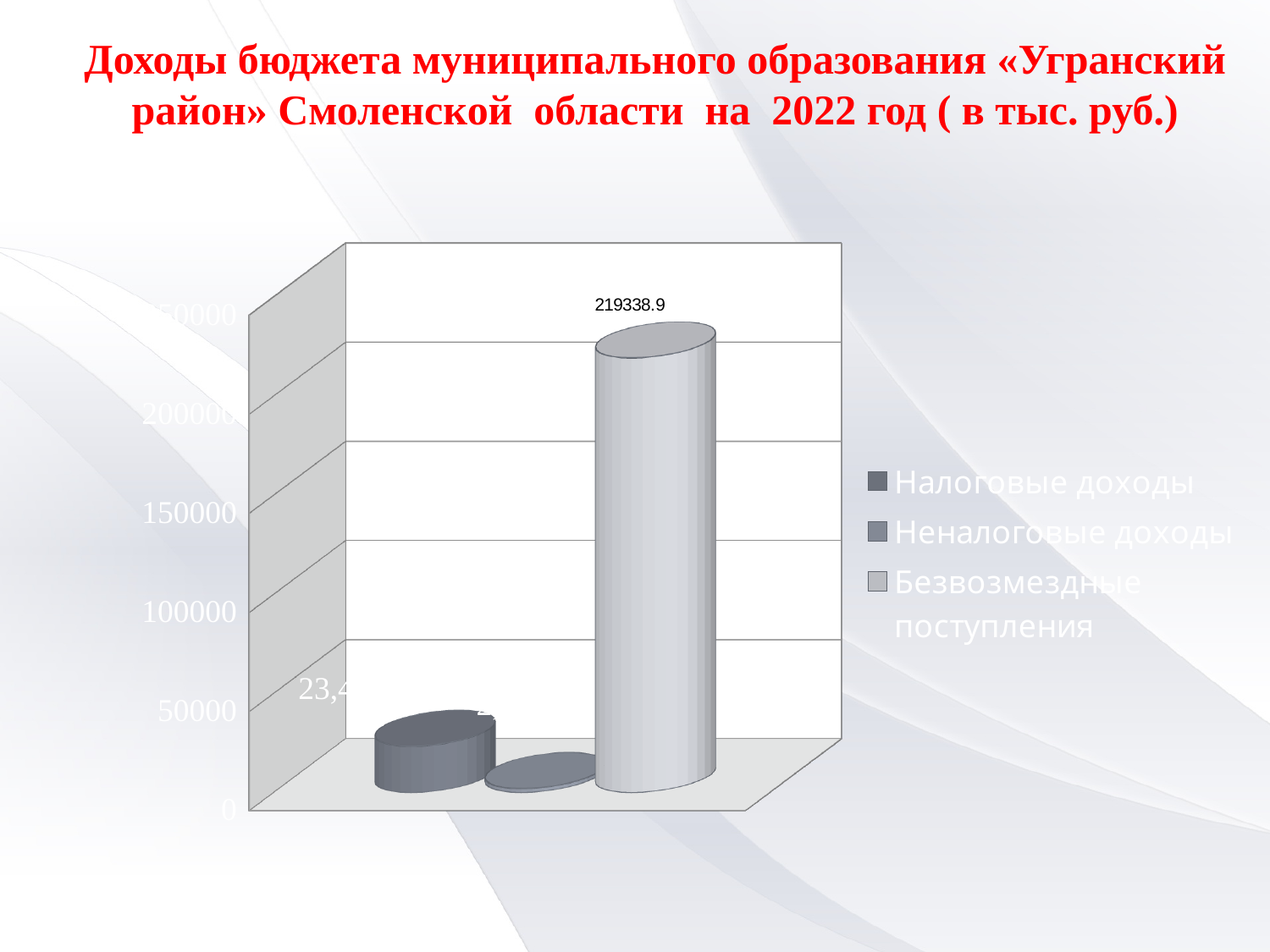
What year does the chart title refer to? 2022 How many bars are plotted on the chart? 3 Which is larger, Налоговые доходы or Неналоговые доходы? Налоговые доходы How many series does the legend list? 3 Which series has the highest value? Безвозмездные поступления Is the value for Безвозмездные поступления greater or less than 200000? greater What kind of chart is shown on the slide? bar chart Which series has the lowest value? Неналоговые доходы Is the value for Налоговые доходы greater or less than 50000? less Is the value for Неналоговые доходы greater or less than 50000? less In what units are the values given according to the title? тыс. руб. What is the value for Безвозмездные поступления? 219338.9